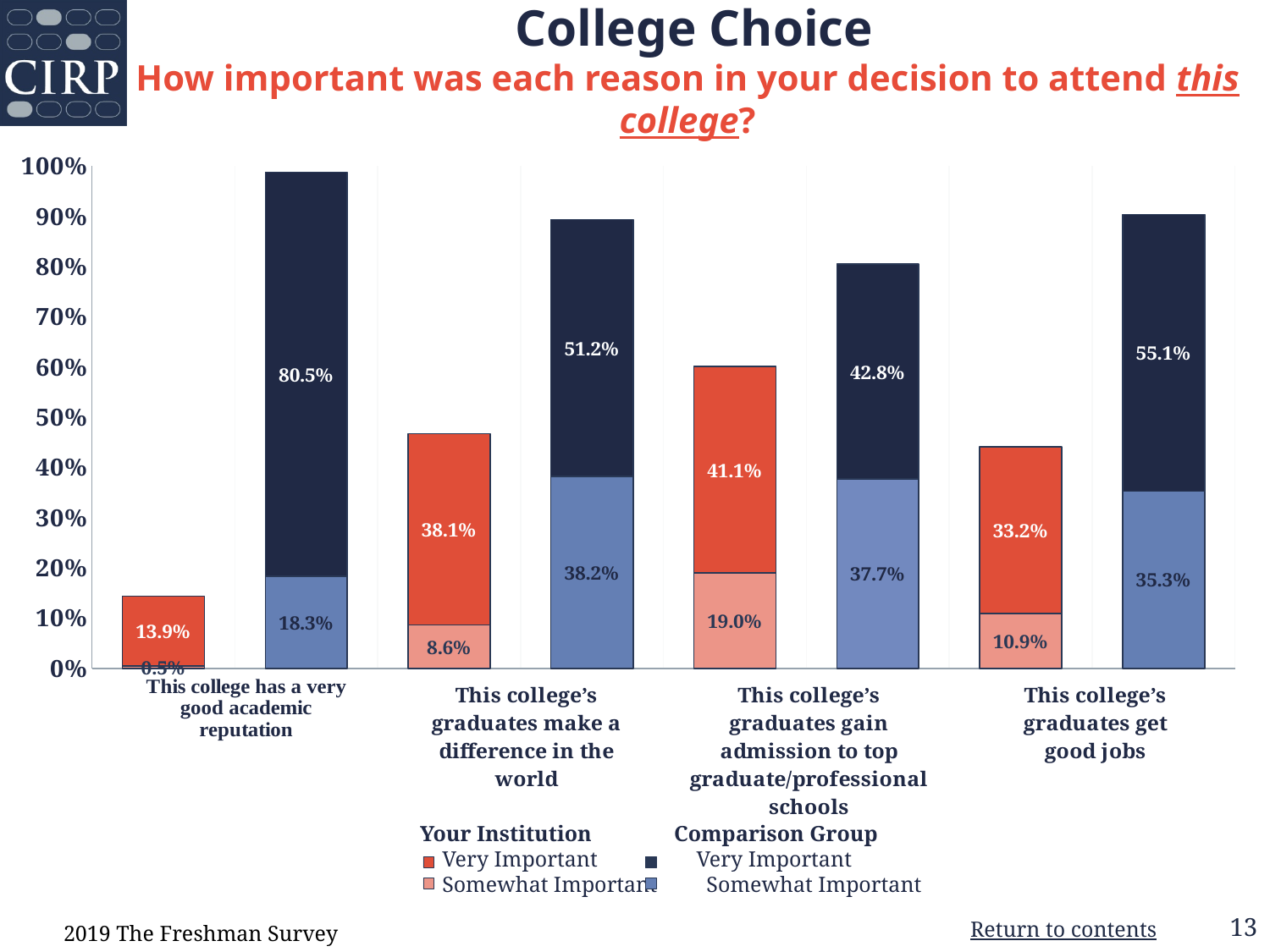
What kind of chart is shown on the slide? Stacked bar chart How many series does the legend list? 4 Which is larger for 'This college's graduates get good jobs': the Comparison Group Very Important value or the Your Institution Very Important value? Comparison Group Very Important How many reasons (categories) are shown on the x axis? 4 What is the total height of the Your Institution stacked bar for 'This college's graduates make a difference in the world'? 46.7% For which reason is the Your Institution Very Important percentage the lowest? This college has a very good academic reputation What is the total height of the Comparison Group stacked bar for 'This college's graduates get good jobs'? 90.4% What percentage of the Comparison Group rated 'This college has a very good academic reputation' as Very Important? 80.5% What is the difference between the Comparison Group and Your Institution Very Important percentages for 'This college has a very good academic reputation'? 66.6 percentage points What percentage of Your Institution respondents rated 'This college's graduates get good jobs' as Somewhat Important? 10.9% What is the Your Institution Very Important value for 'This college's graduates gain admission to top graduate/professional schools'? 41.1% For which reason is the Comparison Group Very Important percentage the highest? This college has a very good academic reputation